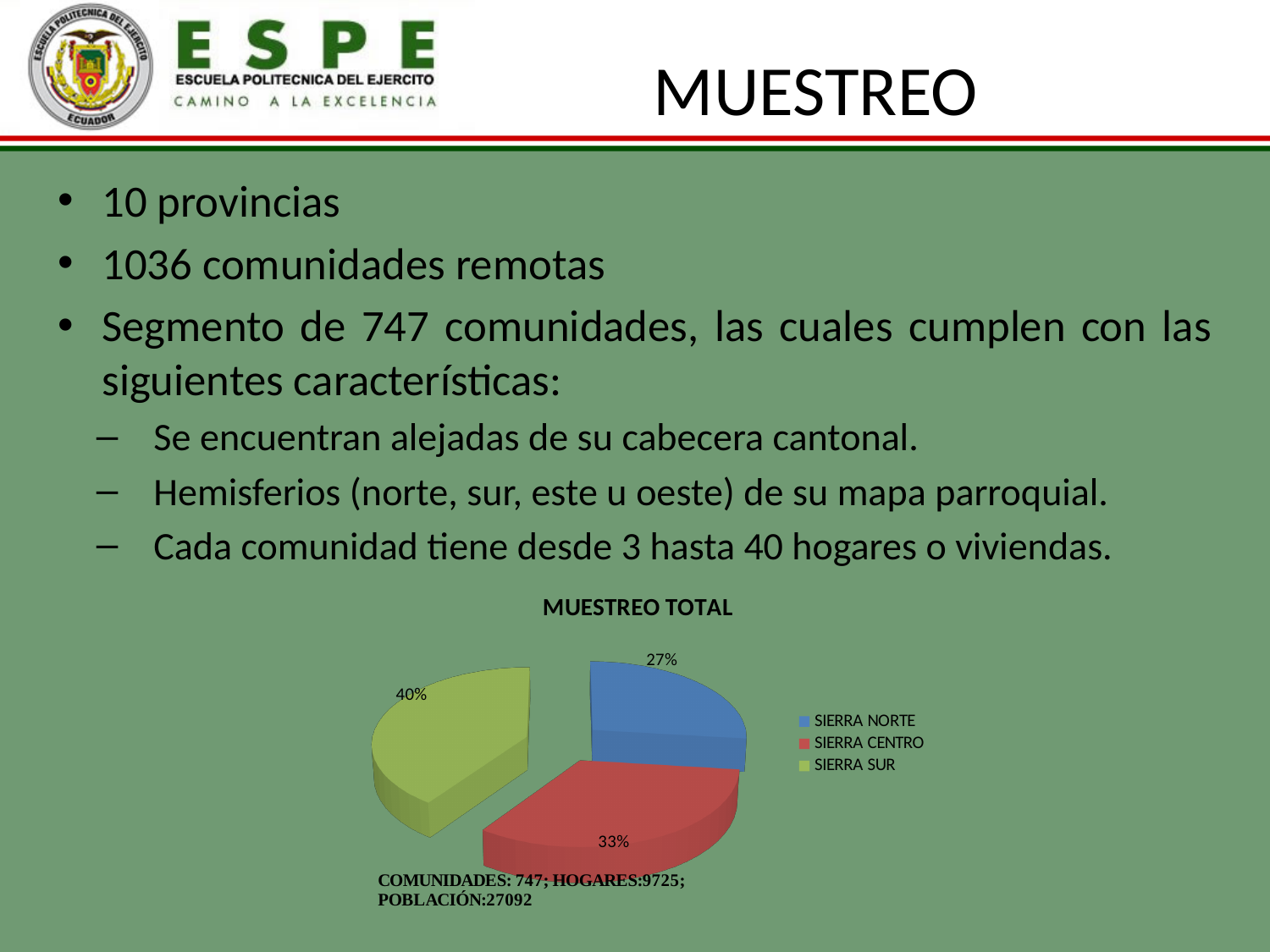
What is the difference in percentage points between SIERRA SUR and SIERRA NORTE? 13 What is the difference in percentage points between SIERRA SUR and SIERRA CENTRO? 7 What is the title of the chart? MUESTREO TOTAL Which category has the largest slice of the pie? SIERRA SUR Which is larger, the share for SIERRA CENTRO or the share for SIERRA NORTE? SIERRA CENTRO What share of the pie does SIERRA NORTE represent? 27% What share of the pie does SIERRA CENTRO represent? 33% What share of the pie does SIERRA SUR represent? 40% What kind of chart is shown on the slide? Pie chart How many categories does the pie chart show? 3 What colour is the SIERRA CENTRO slice in the pie chart? Red Which category has the smallest slice of the pie? SIERRA NORTE